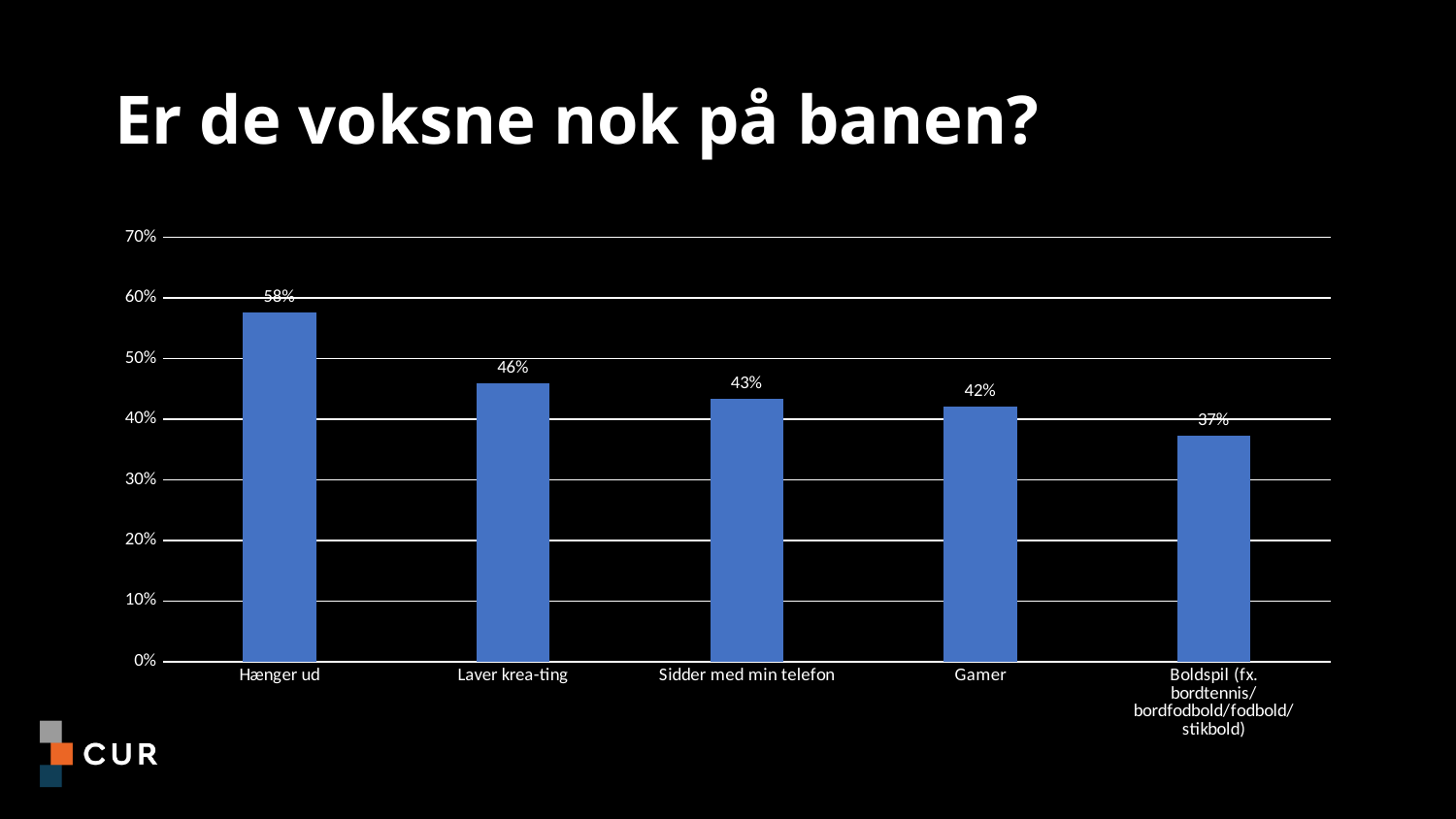
Which category has the lowest value? Boldspil (fx. bordtennis/bordfodbold/fodbold/stikbold) What is the value for Hænger ud? 58% What kind of chart is shown on the slide? Bar chart What is the difference between the values for Hænger ud and Laver krea-ting? 12% How many categories are shown on the x axis? 5 What is the value for Boldspil (fx. bordtennis/bordfodbold/fodbold/stikbold)? 37% What is the value for Gamer? 42% What is the value for Sidder med min telefon? 43% What is the title of the slide? Er de voksne nok på banen? Which category has the highest value? Hænger ud What is the value for Laver krea-ting? 46% Which is larger, the value for Laver krea-ting or the value for Gamer? Laver krea-ting